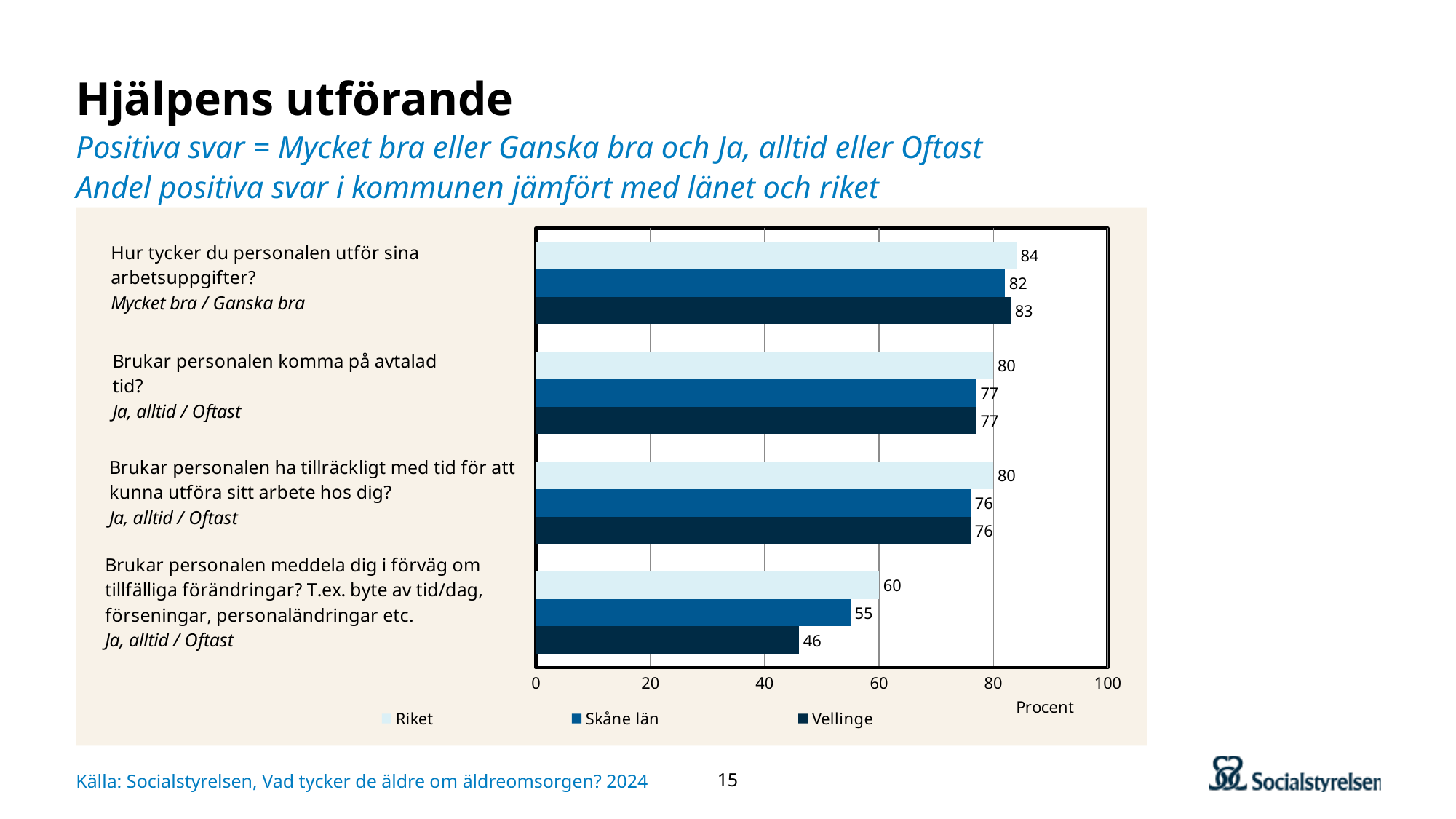
What is the value for Skåne län for "Brukar personalen meddela dig i förväg om tillfälliga förändringar?"? 55 Which series has the lowest value for "Brukar personalen meddela dig i förväg om tillfälliga förändringar?"? Vellinge What is the value for Vellinge for "Hur tycker du personalen utför sina arbetsuppgifter?"? 83 What type of chart is shown on the slide? bar chart What is the difference between Riket and Vellinge for "Brukar personalen meddela dig i förväg om tillfälliga förändringar?"? 14 How many series does the legend list? 3 Which question category has the highest value for Riket? Hur tycker du personalen utför sina arbetsuppgifter? How many question categories are plotted in the chart? 4 What is the difference between Skåne län and Vellinge for "Brukar personalen meddela dig i förväg om tillfälliga förändringar?"? 9 What is the value for Riket for "Brukar personalen komma på avtalad tid?"? 80 What unit label is shown on the x axis of the chart? Procent Which is larger for "Brukar personalen ha tillräckligt med tid för att kunna utföra sitt arbete hos dig?": Riket or Skåne län? Riket